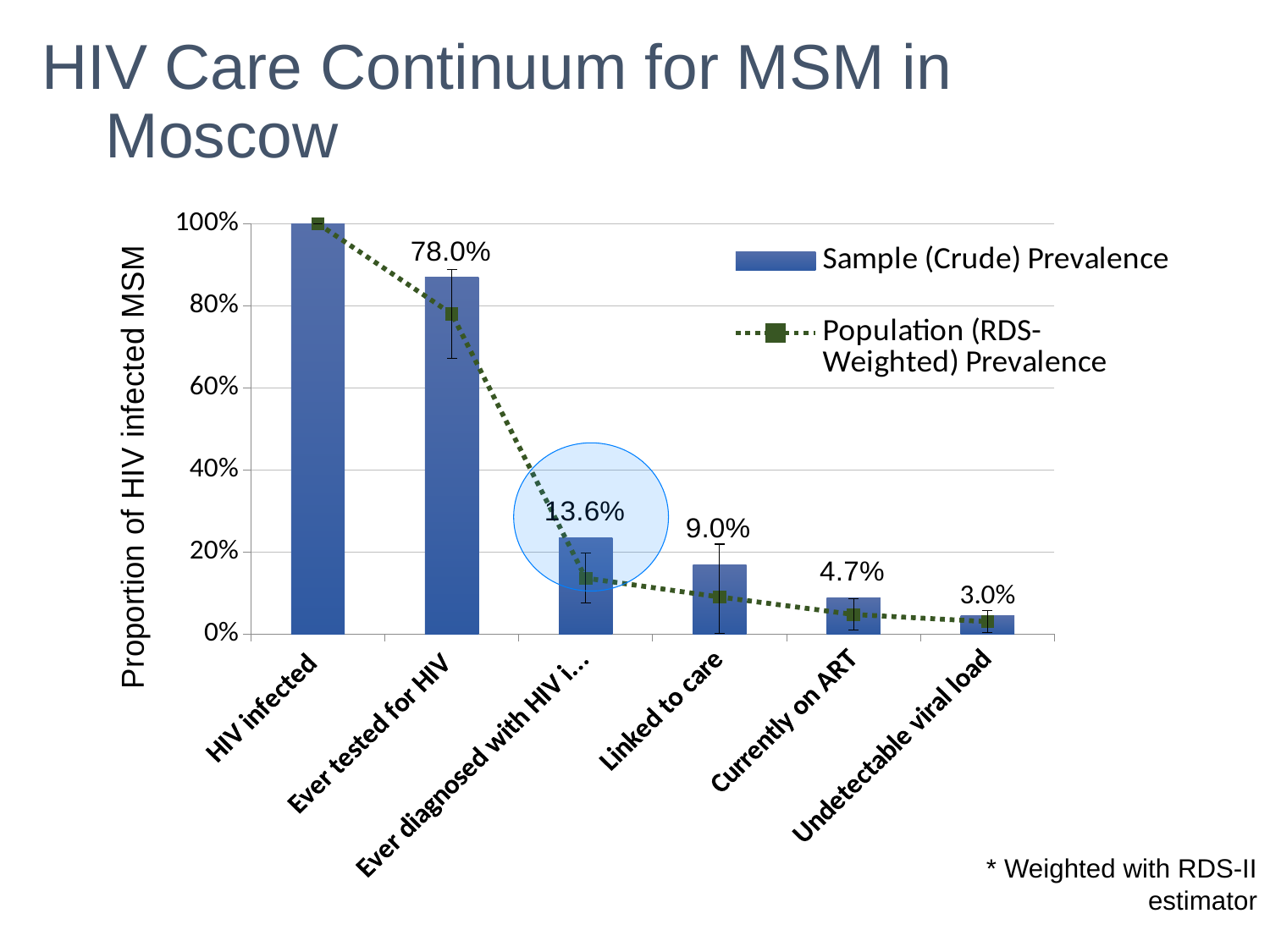
What is the Population (RDS-Weighted) Prevalence for Currently on ART? 4.7% What is the Population (RDS-Weighted) Prevalence for Ever tested for HIV? 78.0% What is the Population (RDS-Weighted) Prevalence for Undetectable viral load? 3.0% What is the Population (RDS-Weighted) Prevalence value highlighted in the circle for Ever diagnosed with HIV? 13.6% What is the Population (RDS-Weighted) Prevalence for Linked to care? 9.0% Which category has the lowest Population (RDS-Weighted) Prevalence? Undetectable viral load What is the difference in Population (RDS-Weighted) Prevalence between Ever tested for HIV and Ever diagnosed with HIV? 64.4 percentage points How many categories are shown along the x axis of the chart? 6 What is the difference in Population (RDS-Weighted) Prevalence between Linked to care and Currently on ART? 4.3 percentage points Is the Sample (Crude) Prevalence bar for Ever tested for HIV greater or less than 80%? greater Do the Population (RDS-Weighted) Prevalence values rise or fall from left to right along the x axis? fall How many series does the chart legend list? 2